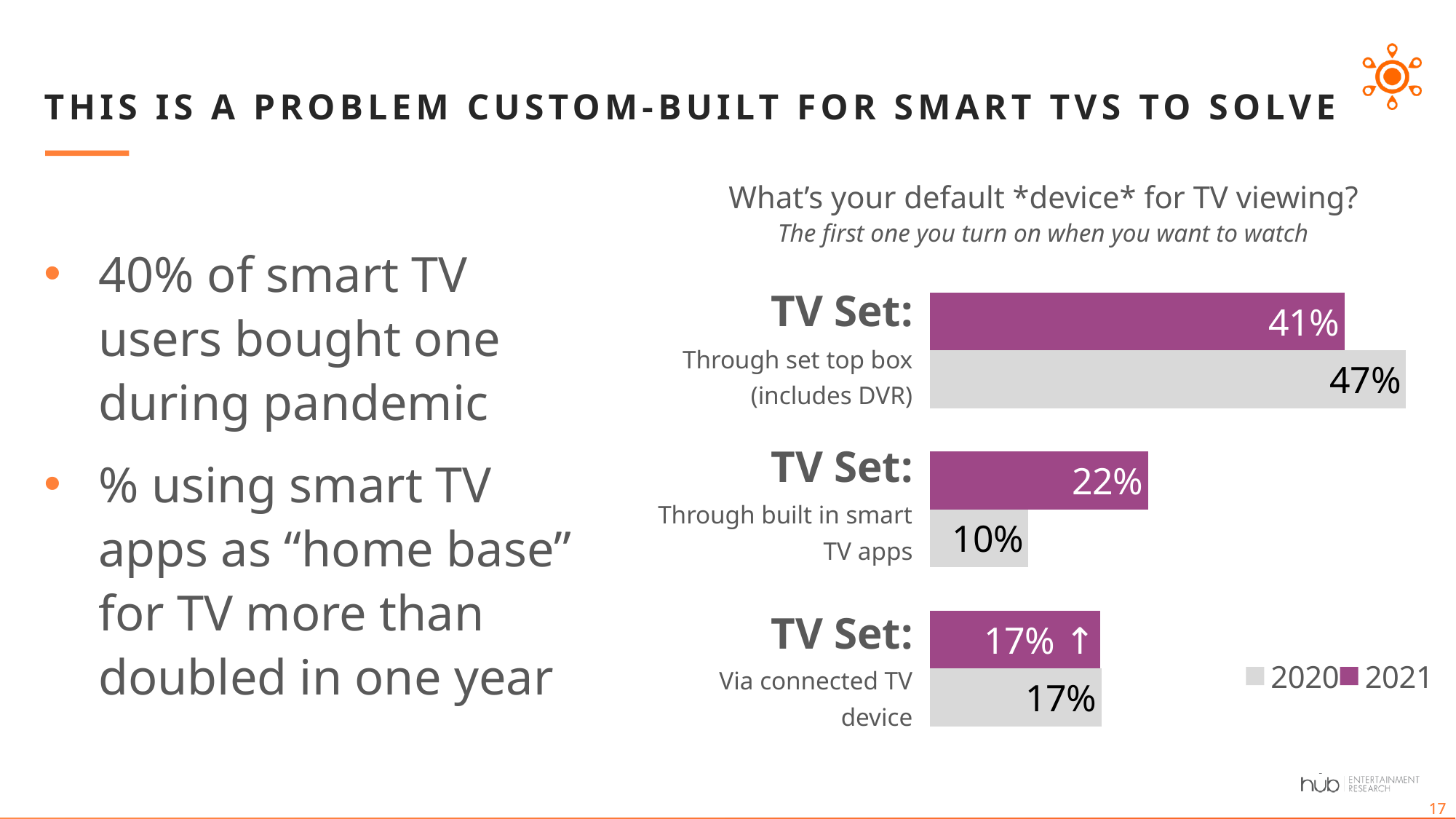
What is the difference between the 2021 and 2020 values for TV Set: Through built in smart TV apps? 12% What is the 2020 value for TV Set: Through built in smart TV apps? 10% What is the 2020 value for TV Set: Through set top box (includes DVR)? 47% How many categories are shown in the chart? 3 For TV Set: Through set top box (includes DVR), which year has the larger value, 2020 or 2021? 2020 How many series does the legend list? 2 What is the 2021 value for TV Set: Through built in smart TV apps? 22% What kind of chart is shown on the slide? Bar chart Which category has the lowest 2020 value? TV Set: Through built in smart TV apps What is the 2020 value for TV Set: Via connected TV device? 17% Which category has the highest 2021 value? TV Set: Through set top box (includes DVR) What is the 2021 value for TV Set: Through set top box (includes DVR)? 41%